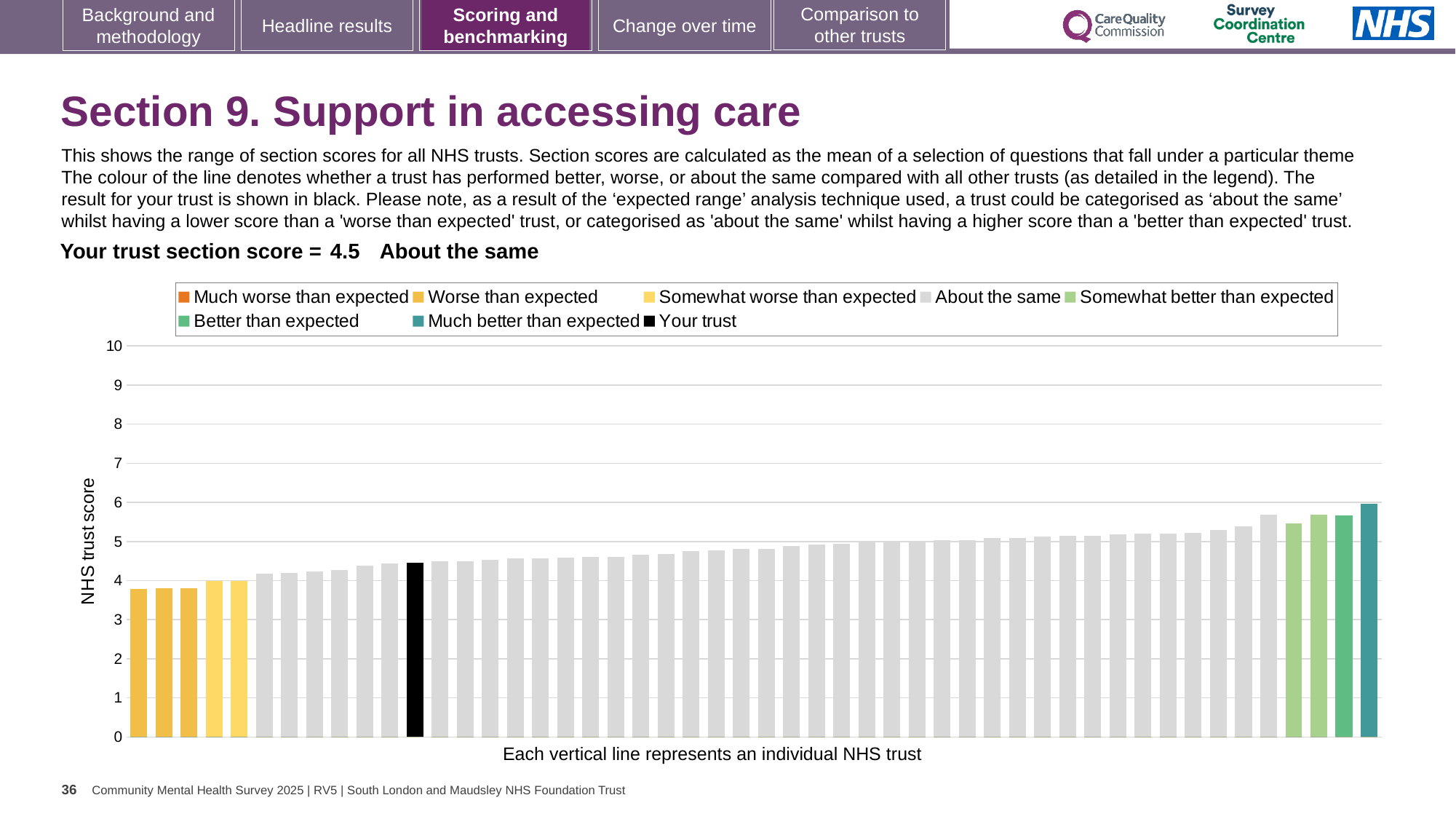
Do the bar values rise or fall from left to right along the x axis? rise Which category is your trust placed in for this section? About the same Is the value of the leftmost bar greater or less than 4? less Is the value of the tallest bar (the rightmost, teal bar) greater or less than 5? greater What kind of chart is shown on the slide? Bar chart What is the label on the vertical axis of the chart? NHS trust score Is the value of the black 'Your trust' bar greater or less than 4? greater How many entries does the chart legend list? 8 How many bars are coloured as 'Much better than expected' (teal)? 1 Which is taller, the leftmost bar or the rightmost bar? the rightmost bar What is the section score for your trust shown on the slide? 4.5